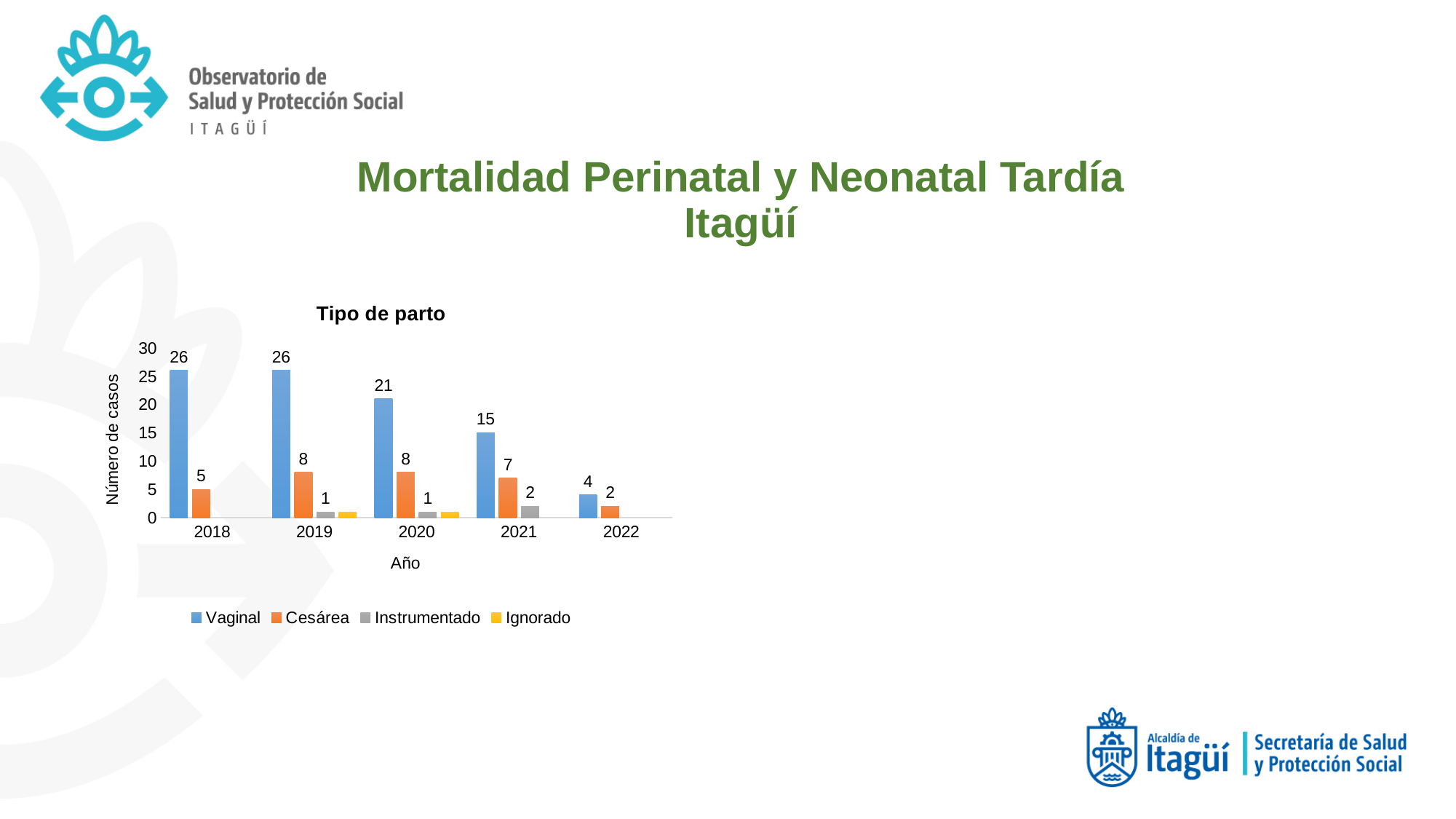
What is the value for Vaginal in 2020? 21 How many years are shown on the x axis? 5 What is the difference between the Vaginal values for 2018 and 2021? 11 In which year is the Cesárea value lowest? 2022 Which is larger, the Cesárea value in 2019 or in 2022? 2019 What kind of chart is shown? bar chart How many series does the legend list? 4 What is the value for Vaginal in 2022? 4 Do the Vaginal values rise or fall from 2019 to 2022? fall Is the Vaginal value for 2019 greater or less than 20? greater What is the value for Instrumentado in 2019? 1 What is the value for Cesárea in 2021? 7